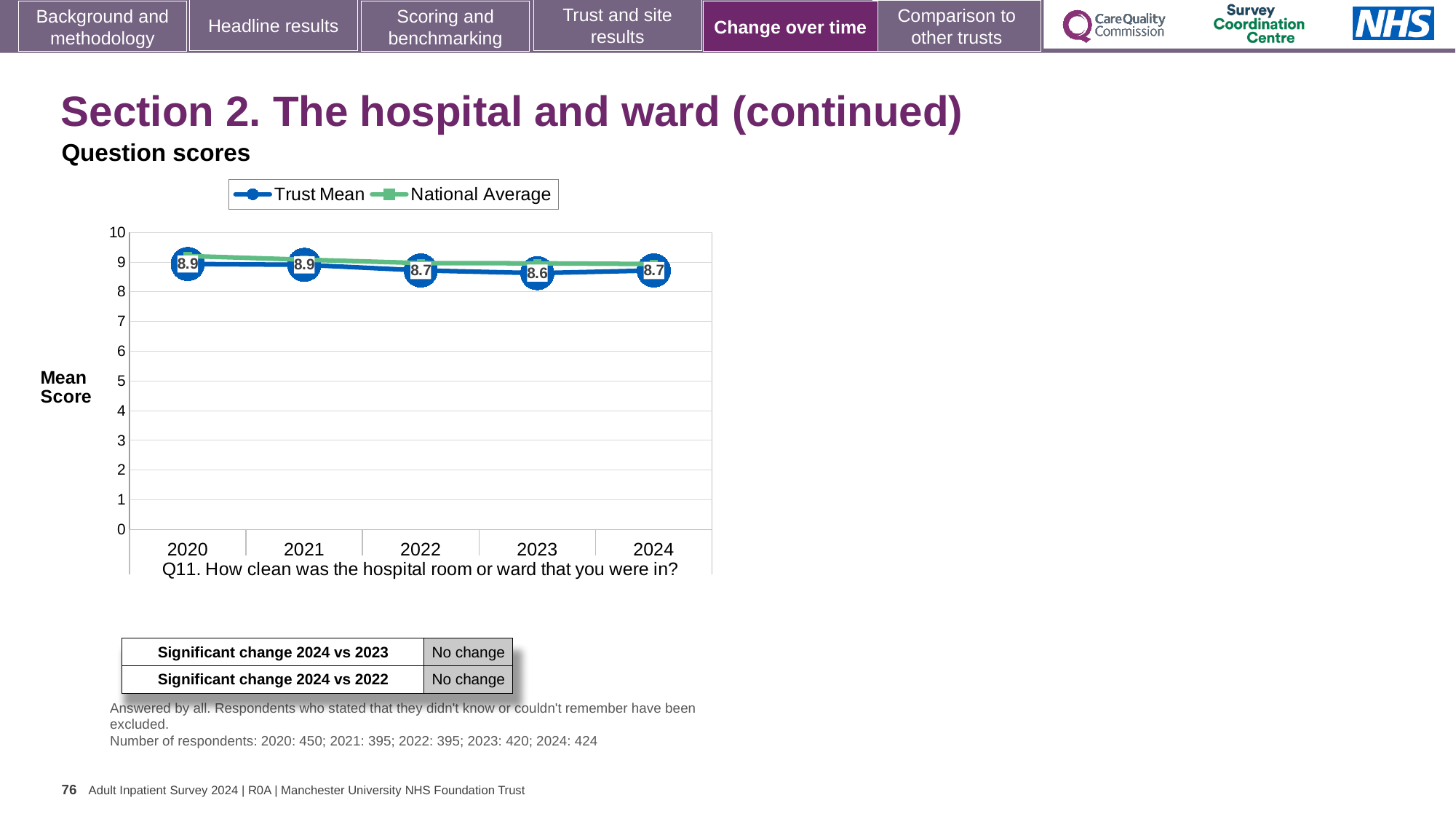
Does the Trust Mean rise or fall from 2020 to 2024? fall How many series does the legend list? 2 What kind of chart is shown on the slide? line chart What is the Trust Mean value for 2023? 8.6 Which survey question does the chart show scores for? Q11. How clean was the hospital room or ward that you were in? What is the Trust Mean value for 2024? 8.7 How many years are shown on the x axis? 5 What is the Trust Mean value for 2020? 8.9 Is the National Average value for 2024 greater or less than 8? greater In which year is the Trust Mean lowest? 2023 Which is larger, the Trust Mean for 2021 or for 2023? 2021 What is the difference between the Trust Mean in 2020 and in 2023? 0.3